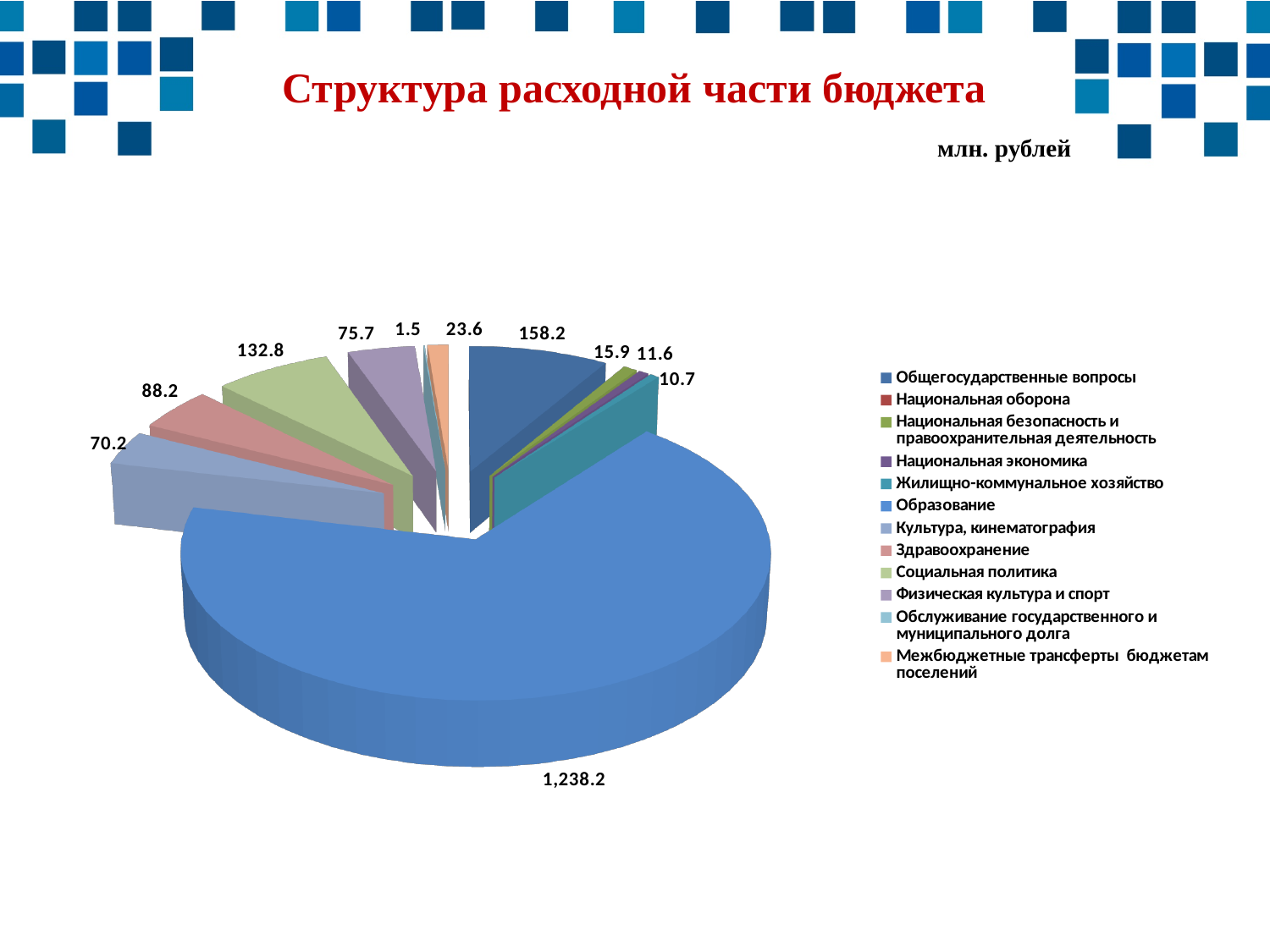
In what units are the values on the chart given, according to the slide? млн. рублей What is the value for Здравоохранение? 88.2 What kind of chart is shown on the slide? pie chart What is the value for Социальная политика? 132.8 What is the value for Общегосударственные вопросы? 158.2 Which is larger, the value for Физическая культура и спорт or the value for Культура, кинематография? Физическая культура и спорт What is the difference between the values for Социальная политика and Здравоохранение? 44.6 What is the value for Образование? 1,238.2 How many categories does the legend of the pie chart list? 12 Which category has the largest slice of the pie? Образование What is the value for Межбюджетные трансферты бюджетам поселений? 23.6 What is the difference between the values for Общегосударственные вопросы and Социальная политика? 25.4